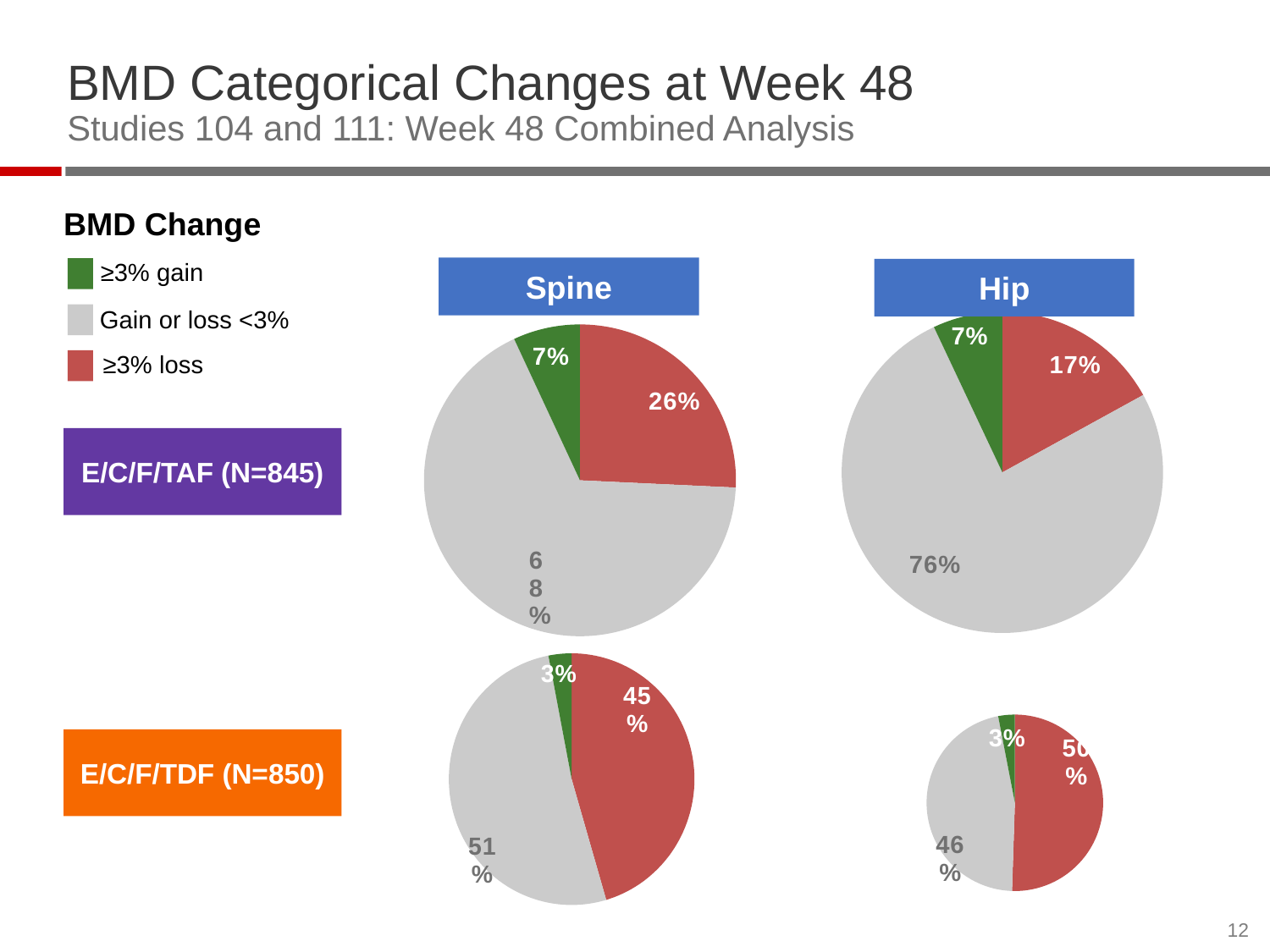
In the E/C/F/TDF Hip pie chart, what percentage had a gain or loss <3%? 46% How many BMD change categories does the legend list? 3 In the E/C/F/TDF Spine pie chart, what percentage had a ≥3% loss? 45% In the E/C/F/TAF Hip pie chart, what percentage of patients had a ≥3% loss? 17% In the E/C/F/TAF Spine pie chart, which category has the smallest share? ≥3% gain Which is larger: the ≥3% loss share in the E/C/F/TAF Spine pie chart or in the E/C/F/TAF Hip pie chart? E/C/F/TAF Spine In the E/C/F/TAF Hip pie chart, which category has the largest share? Gain or loss <3% In the E/C/F/TDF Spine pie chart, what percentage of patients had a ≥3% gain? 3% In the E/C/F/TAF Hip pie chart, what percentage had a gain or loss <3%? 76% In the E/C/F/TAF Spine pie chart, what percentage of patients had a ≥3% loss in BMD? 26% In the E/C/F/TAF Spine pie chart, what percentage had a gain or loss <3%? 68% What is the difference between the ≥3% loss share in the E/C/F/TDF Spine pie chart and the ≥3% loss share in the E/C/F/TAF Spine pie chart? 19%